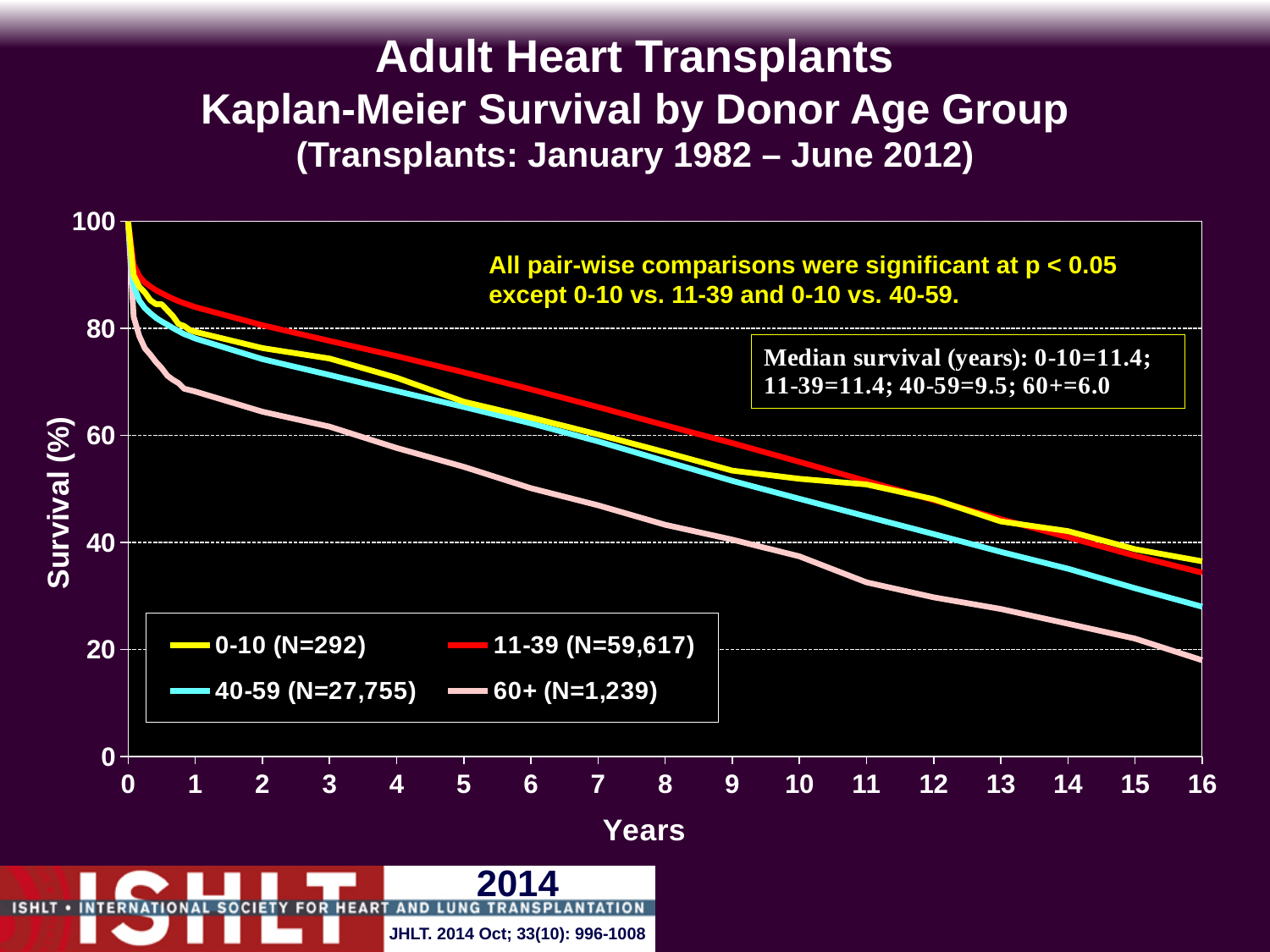
What is the difference in median survival (years) between the 0-10 and 60+ donor age groups? 5.4 Which has a larger median survival, the 40-59 group or the 60+ group? 40-59 Is the survival value for the 60+ group at 16 years greater or less than 20? less What is the median survival in years for the 60+ donor age group? 6.0 Which donor age group has the lowest median survival? 60+ Do the survival curves rise or fall as years increase? fall How many donor age groups (series) does the legend list? 4 What is the median survival in years for the 11-39 donor age group? 11.4 Is the survival value for the 11-39 group at 5 years greater or less than 60? greater What is the median survival in years for the 40-59 donor age group? 9.5 What is the N shown in the legend for the 11-39 donor age group? 59,617 What kind of chart is shown on the slide? line chart